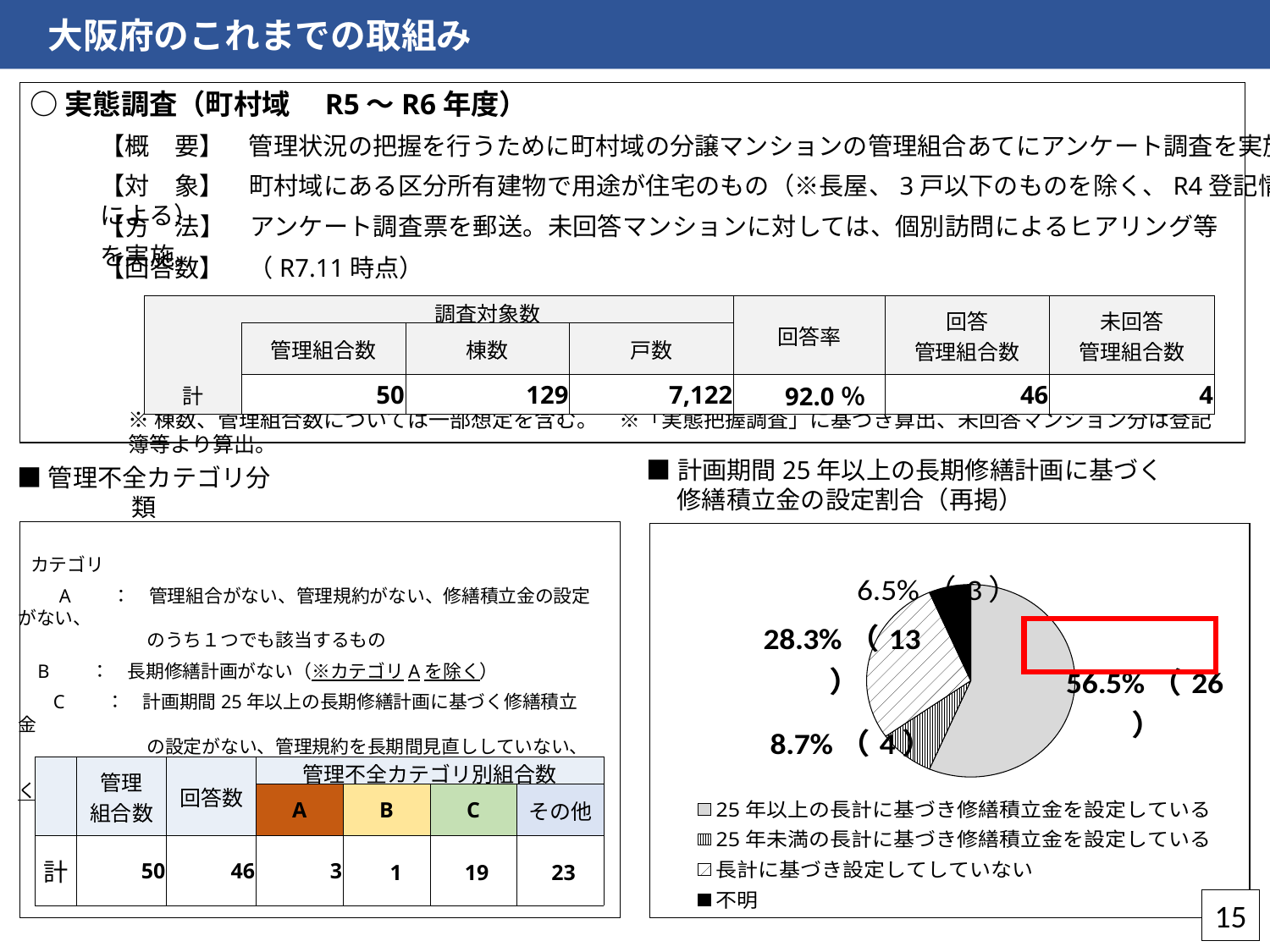
In the pie chart, how many cases (the number in parentheses) are in the 25年以上の長計に基づき修繕積立金を設定している slice? 26 In the pie chart, what percentage share is shown for 長計に基づき設定してしていない? 28.3% Which slice of the pie chart is the largest? 25年以上の長計に基づき修繕積立金を設定している How many slices does the pie chart have? 4 In the pie chart, what percentage share is shown for 25年未満の長計に基づき修繕積立金を設定している? 8.7% What kind of chart is shown under the heading 計画期間25年以上の長期修繕計画に基づく修繕積立金の設定割合（再掲）? pie chart In the pie chart, what is the difference in percentage points between the 56.5% slice and the 28.3% slice? 28.2 In the pie chart, what percentage share is shown for 25年以上の長計に基づき修繕積立金を設定している? 56.5% In the pie chart, how many cases (the number in parentheses) are in the 不明 slice? 3 Which slice of the pie chart is the smallest? 不明 In the pie chart, what percentage share is shown for 不明? 6.5% In the pie chart, which slice is larger: 25年未満の長計に基づき修繕積立金を設定している or 不明? 25年未満の長計に基づき修繕積立金を設定している